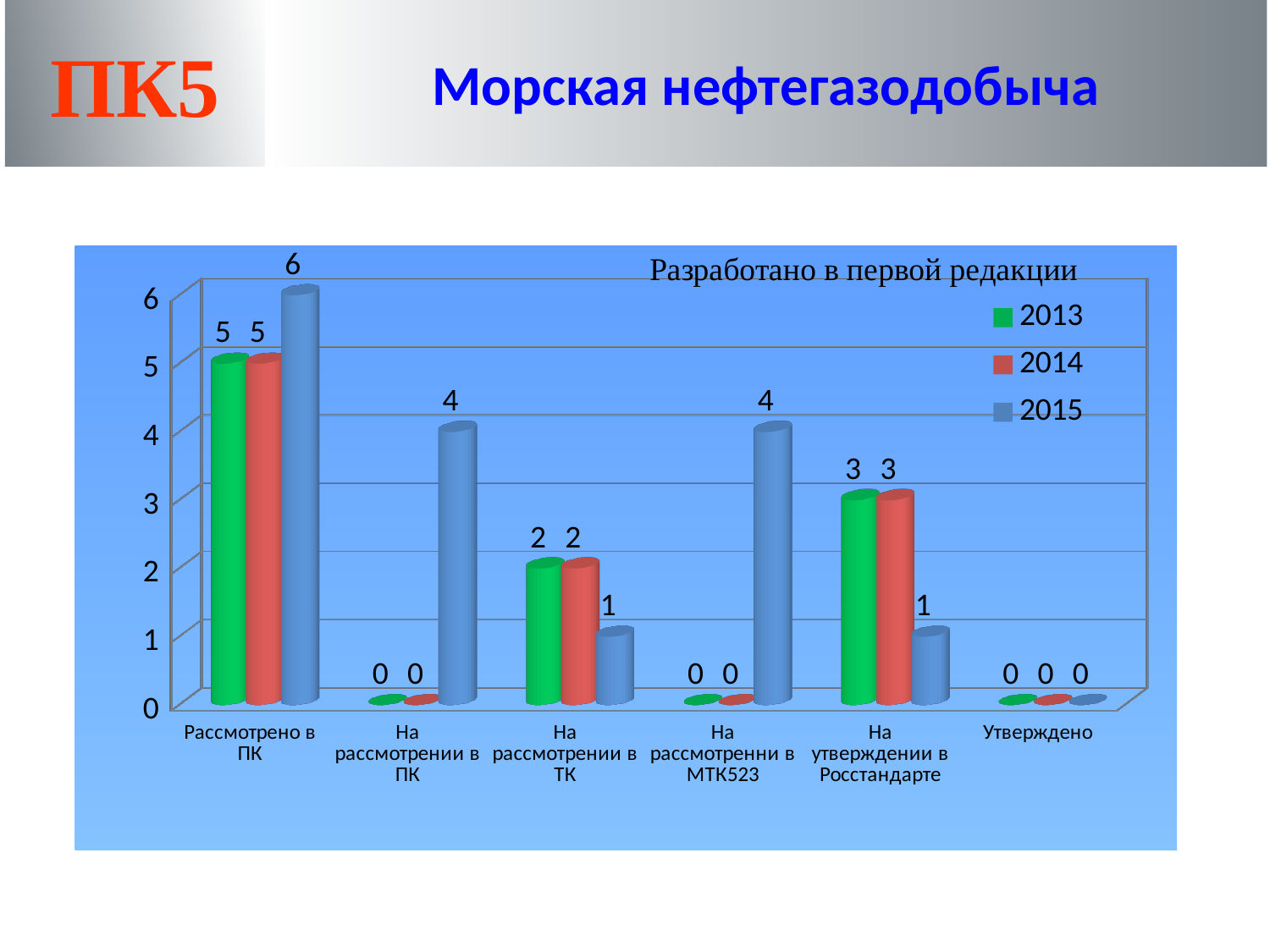
What is the difference between the 2013 and 2015 values in the category "На утверждении в Росстандарте"? 2 How many categories are shown on the x axis? 6 How many series does the legend list? 3 What is the value for 2015 in the category "Рассмотрено в ПК"? 6 What is the value for 2015 in the category "На рассмотрении в ТК"? 1 What is the title of the chart? Разработано в первой редакции What is the value for 2014 in the category "На рассмотрении в ПК"? 0 What is the value for 2013 in the category "На утверждении в Росстандарте"? 3 What kind of chart is shown on the slide? Bar chart What is the difference between the 2015 and 2013 values in the category "Рассмотрено в ПК"? 1 In the category "На рассмотренни в МТК523", which series has the larger value, 2013 or 2015? 2015 Which category has the highest value for the 2015 series? Рассмотрено в ПК